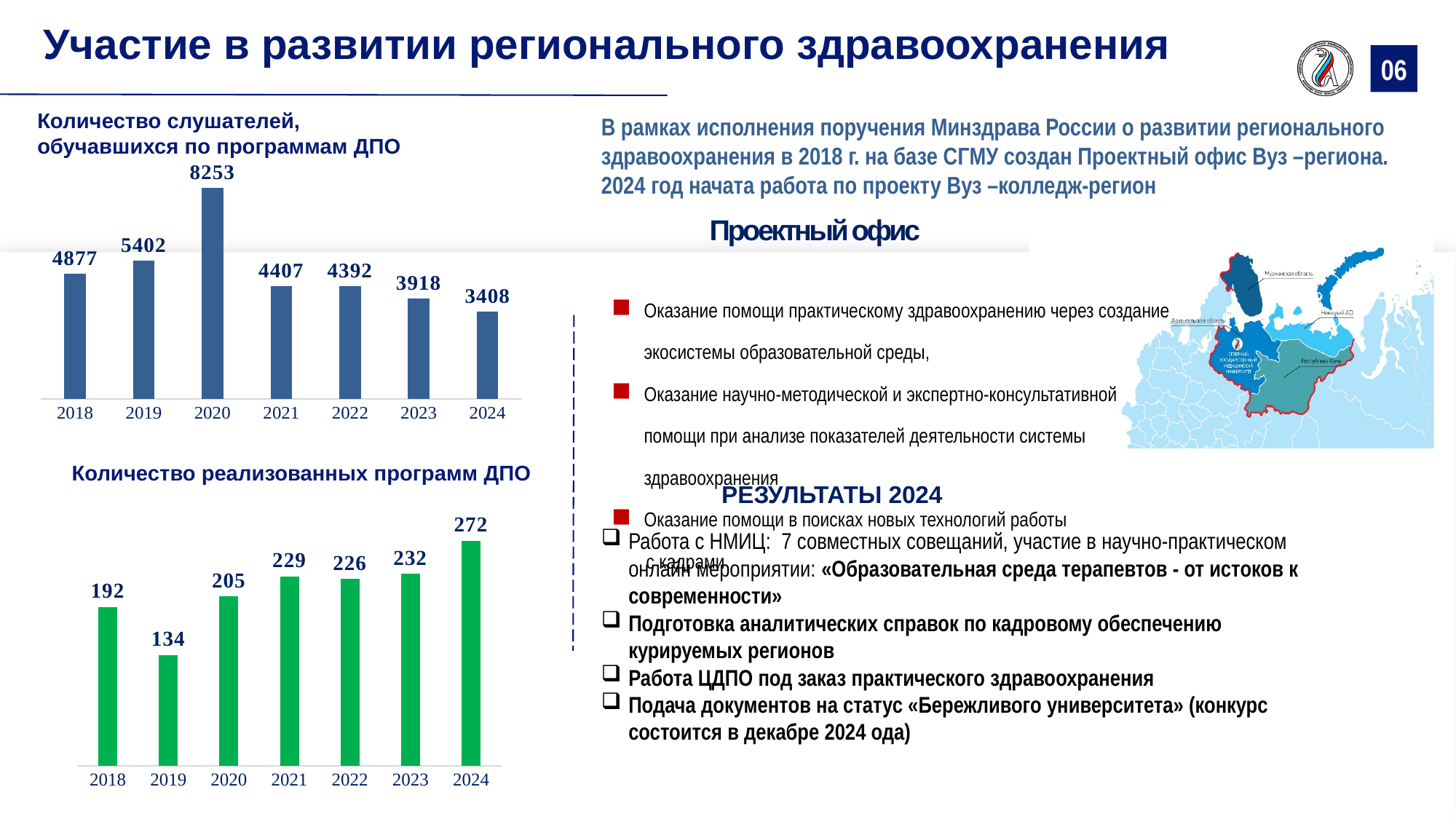
In the top chart (Количество слушателей, обучавшихся по программам ДПО), which year has the highest value? 2020 In the bottom chart (Количество реализованных программ ДПО), which is larger, the value for 2018 or the value for 2020? 2020 In the top chart (Количество слушателей, обучавшихся по программам ДПО), what is the value for 2020? 8253 What type of chart is the bottom chart (Количество реализованных программ ДПО)? Bar chart In the bottom chart (Количество реализованных программ ДПО), which year has the lowest value? 2019 In the top chart (Количество слушателей, обучавшихся по программам ДПО), which year has the lowest value? 2024 In the bottom chart (Количество реализованных программ ДПО), which year has the highest value? 2024 In the bottom chart (Количество реализованных программ ДПО), what is the difference between the values for 2024 and 2023? 40 In the top chart (Количество слушателей, обучавшихся по программам ДПО), what is the value for 2024? 3408 In the bottom chart (Количество реализованных программ ДПО), what is the value for 2019? 134 In the top chart (Количество слушателей, обучавшихся по программам ДПО), how many years are shown on the x axis? 7 In the top chart (Количество слушателей, обучавшихся по программам ДПО), what is the difference between the values for 2020 and 2019? 2851